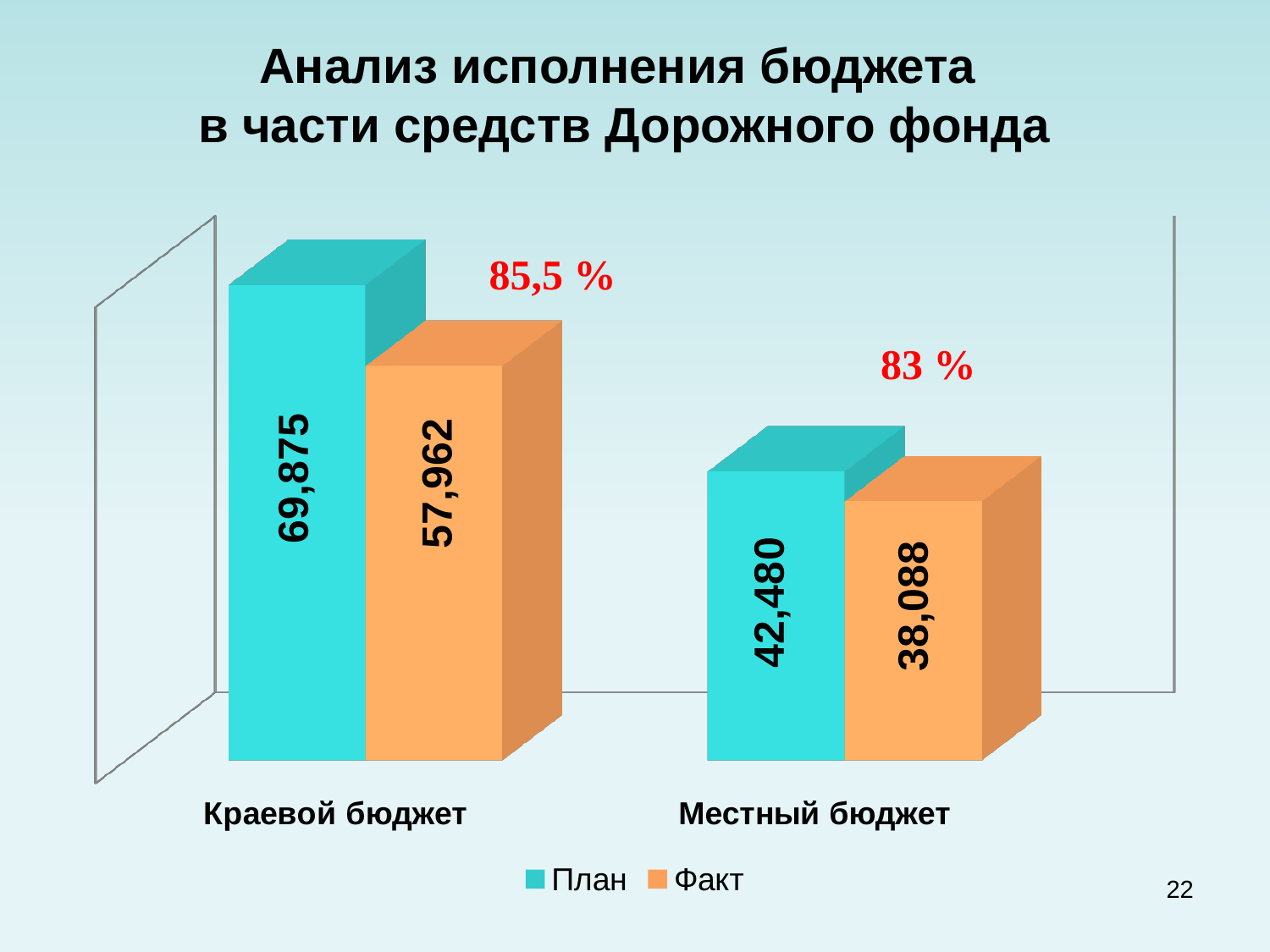
What is the План value for Местный бюджет? 42,480 What is the План value for Краевой бюджет? 69,875 Which bar has the lowest value on the chart? Факт for Местный бюджет What is the Факт value for Местный бюджет? 38,088 Which is larger: the Факт value for Краевой бюджет or the План value for Местный бюджет? Факт for Краевой бюджет What type of chart is shown on the slide? Bar chart What percentage is shown in red above the Местный бюджет bars? 83 % What is the difference between the План and Факт values for Местный бюджет? 4,392 What is the difference between the План and Факт values for Краевой бюджет? 11,913 How many series does the legend list? 2 Which category has the highest План value? Краевой бюджет What is the Факт value for Краевой бюджет? 57,962